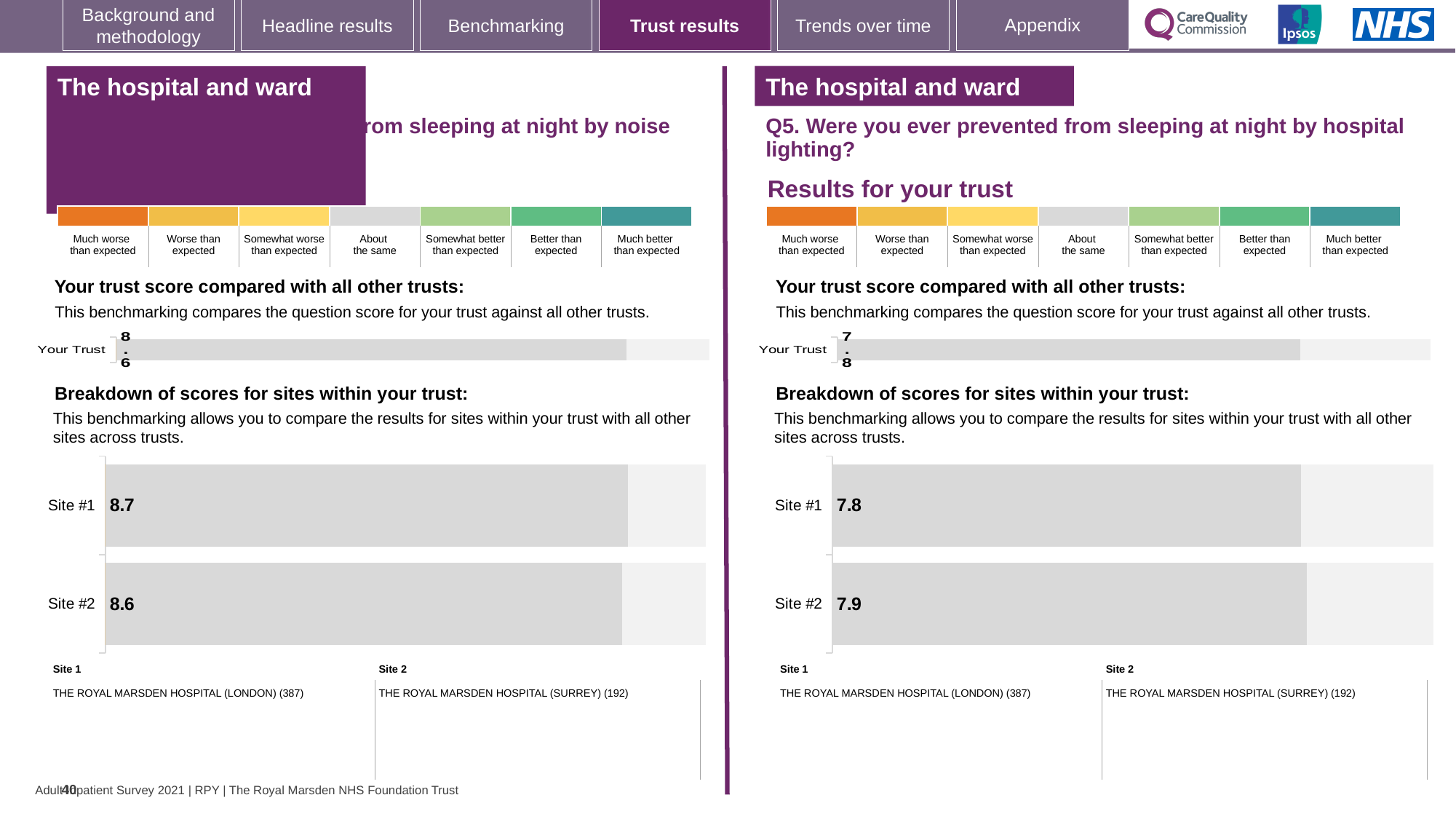
On the right-hand side of the slide (Q5, hospital lighting), what is the 'Your Trust' score shown in the trust comparison bar? 7.8 On the left-hand side of the slide, what is the 'Your Trust' score shown in the trust comparison bar? 8.6 On the right-hand site breakdown chart (Q5, hospital lighting), what is the difference between the Site #2 and Site #1 scores? 0.1 On the right-hand chart (Q5, hospital lighting), what is the score for Site #1? 7.8 On the left-hand chart (sleeping at night by noise), what is the score for Site #2? 8.6 How many sites are shown in the site breakdown chart on the right-hand side of the slide? 2 What type of chart is used for the site breakdown on the left-hand side of the slide? Bar chart On the left-hand site breakdown chart, which site has the higher score? Site #1 On the right-hand site breakdown chart (Q5, hospital lighting), which site has the lower score? Site #1 On the left-hand chart (sleeping at night by noise), what is the score for Site #1? 8.7 On the left-hand site breakdown chart, what is the difference between the Site #1 and Site #2 scores? 0.1 On the right-hand chart (Q5, hospital lighting), what is the score for Site #2? 7.9